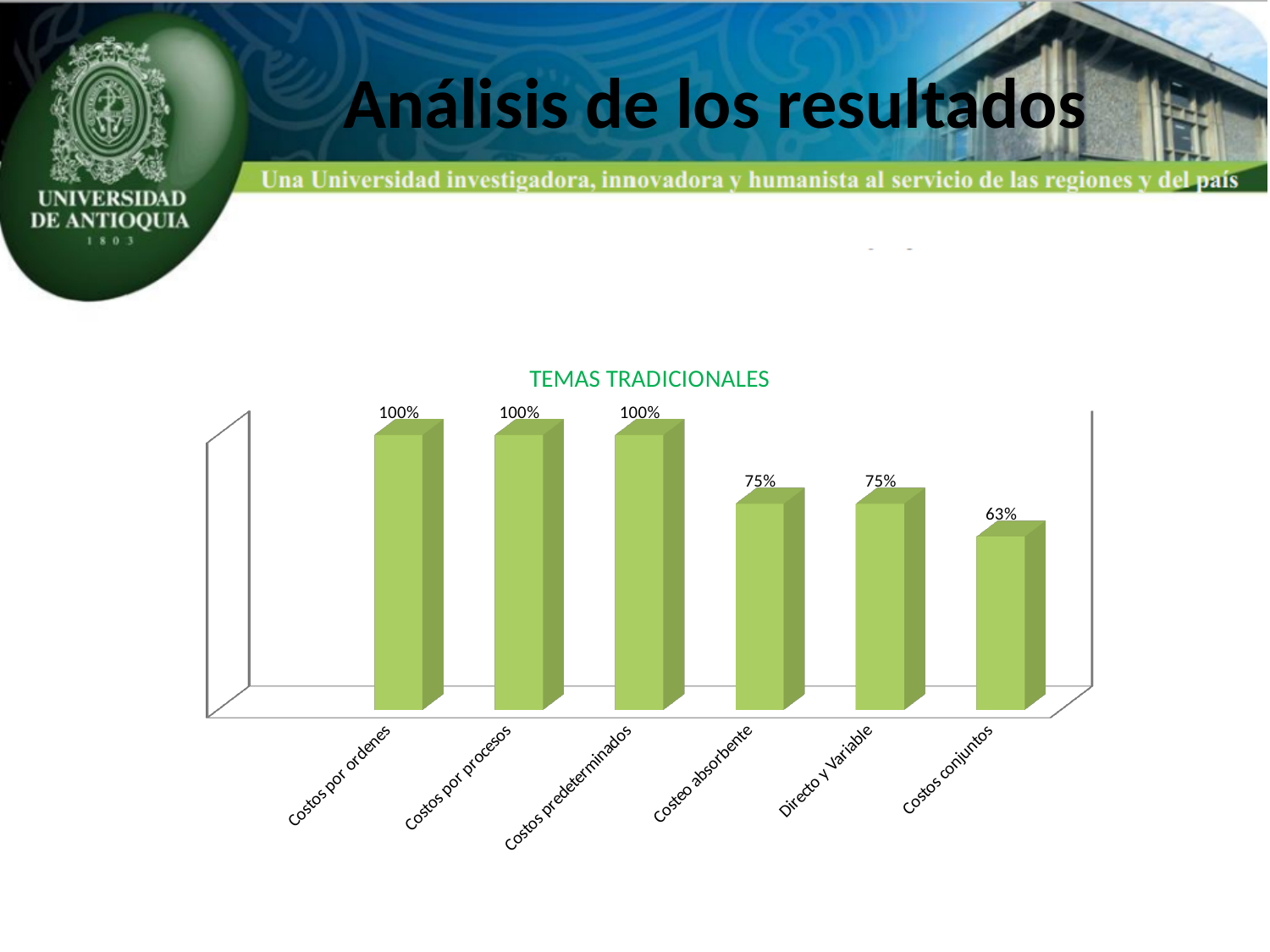
What is the value for Costos conjuntos? 63% What kind of chart is shown on the slide? Bar chart Which is larger, the value for Costos predeterminados or the value for Directo y Variable? Costos predeterminados What is the difference between the values for Costeo absorbente and Costos conjuntos? 12% What is the title of the chart? TEMAS TRADICIONALES What is the value for Costos por ordenes? 100% What is the value for Directo y Variable? 75% Do the values rise or fall from left to right along the x axis? Fall Which category has the lowest value? Costos conjuntos What is the value for Costeo absorbente? 75% How many categories are shown on the chart? 6 What is the difference between the values for Costos por procesos and Costos conjuntos? 37%